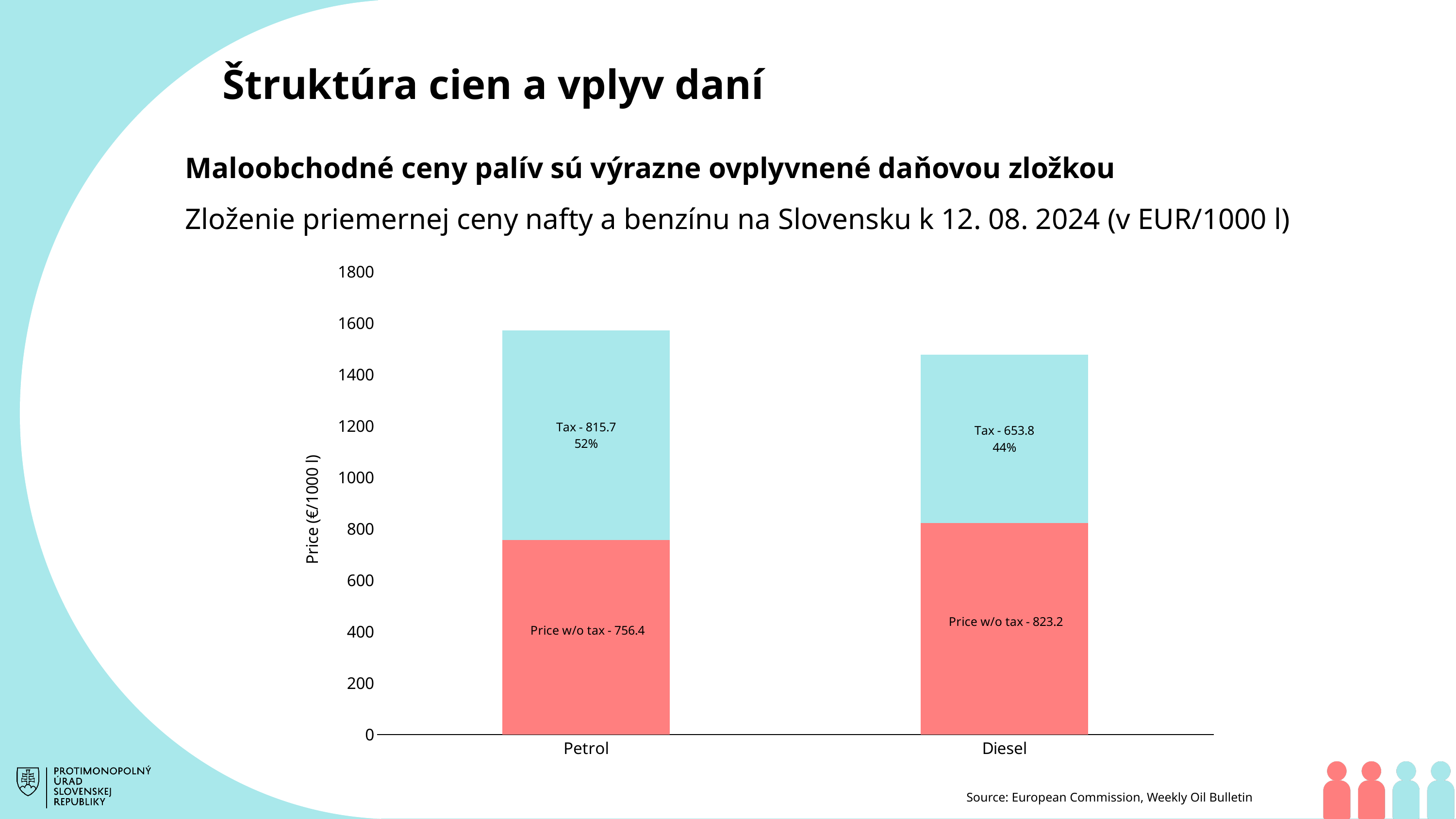
How many fuel categories are shown on the x axis? 2 What percentage of the Petrol price is tax? 52% What is the tax component for Petrol? 815.7 What is the difference between the tax on Petrol and the tax on Diesel? 161.9 What percentage of the Diesel price is tax? 44% Which fuel has the higher tax component? Petrol Which fuel has the lower price without tax? Petrol Is the price without tax higher for Petrol or for Diesel? Diesel Is the total bar for Diesel greater or less than 1400? greater What is the total price of Petrol (tax plus price without tax)? 1572.1 What is the price without tax for Diesel? 823.2 What type of chart is shown on the slide? Stacked bar chart